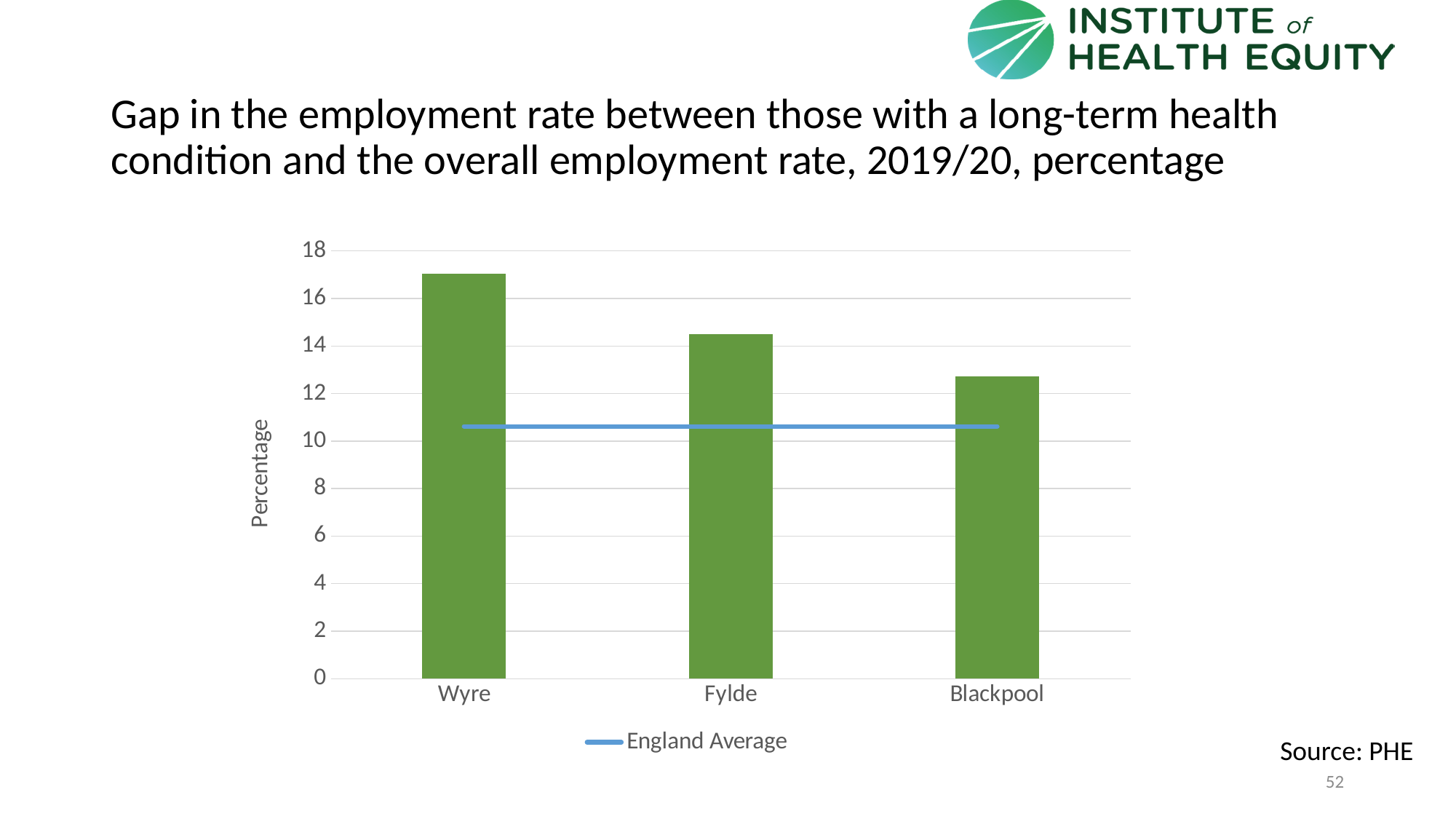
How many entries does the chart legend list? 1 What kind of chart is shown on the slide? combination bar and line chart Is the England Average line greater or less than 12? less Is the value for Wyre greater or less than 16? greater Do the bar values rise or fall from Wyre to Blackpool along the x axis? fall Which is larger, the value for Fylde or the value for Blackpool? Fylde Which area has the lowest employment rate gap in the chart? Blackpool Is the value for Fylde greater or less than 14? greater What is the label on the vertical axis of the chart? Percentage How many local areas are shown on the x axis of the chart? 3 Which area has the highest employment rate gap in the chart? Wyre